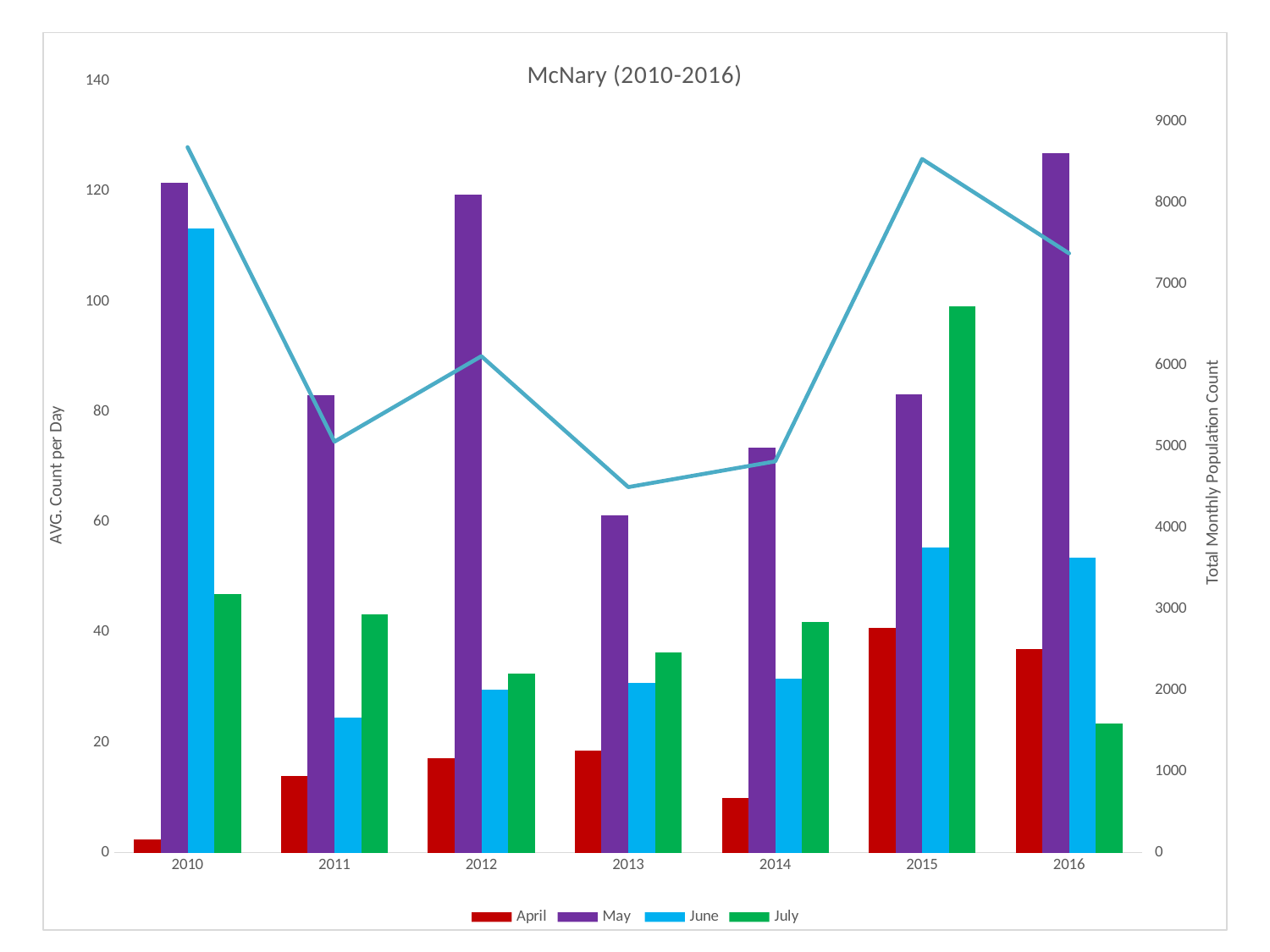
In which year is the May bar the highest? 2016 Which is larger in 2010, the June bar or the July bar? June Is the June value for 2010 greater or less than 100? greater What is the title of the chart? McNary (2010-2016) What kind of chart is this? bar chart with a line How many series does the legend list? 4 Does the line rise or fall from 2010 to 2013? fall Is the July value for 2016 greater or less than 40? less In which year is the July bar the highest? 2015 How many years are shown on the x axis? 7 Is the April value for 2014 greater or less than 20? less In which year is the April bar the lowest? 2010